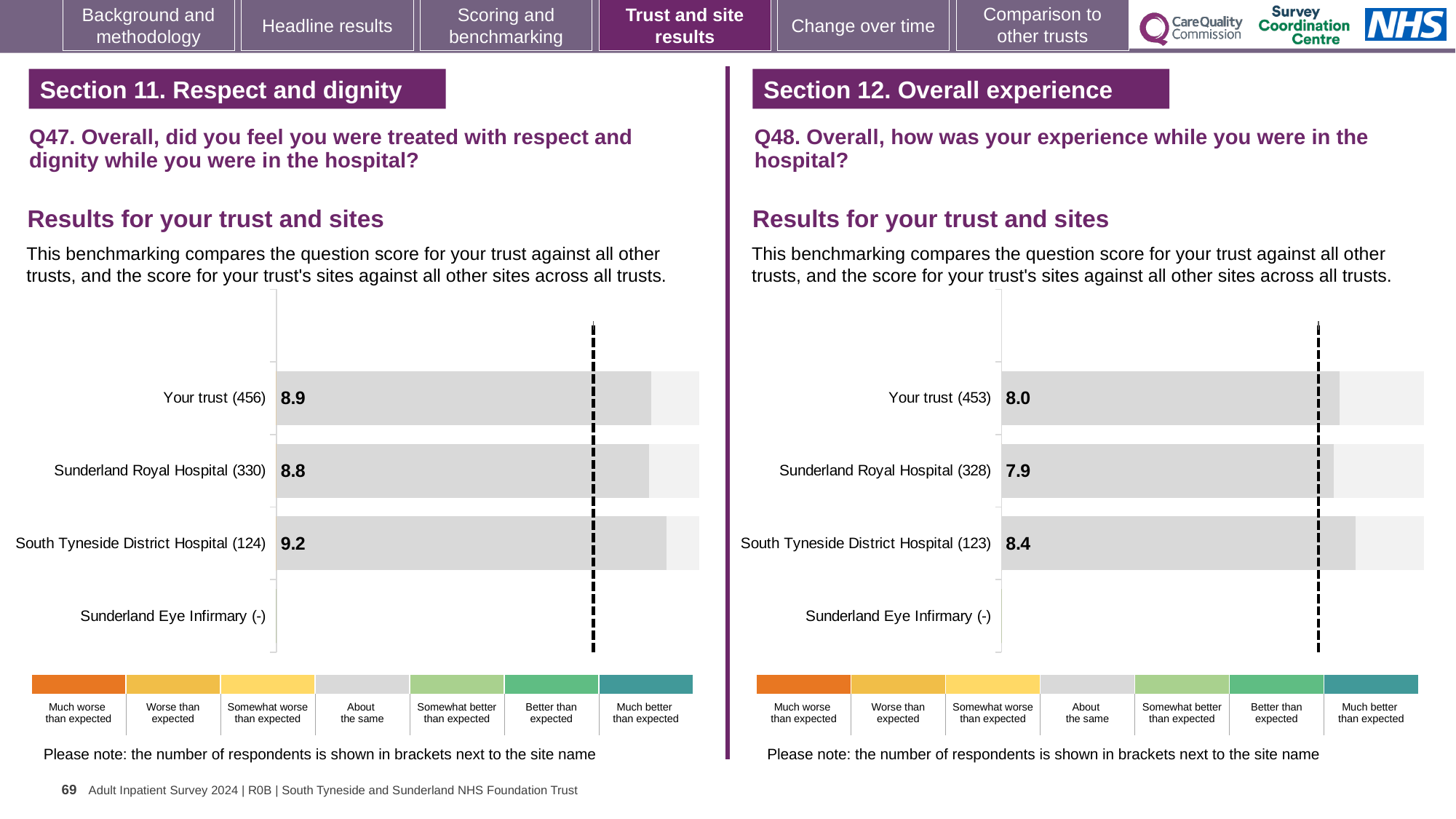
How many rows (trust and sites) are listed on the Q47 chart (Section 11. Respect and dignity)? 4 On the Q47 chart (Section 11. Respect and dignity), how many respondents are shown in brackets for Sunderland Royal Hospital? 330 On the Q47 chart (Section 11. Respect and dignity), what is the score for Your trust? 8.9 On the Q47 chart (Section 11. Respect and dignity), what is the difference between the scores for South Tyneside District Hospital and Sunderland Royal Hospital? 0.4 On the Q48 chart (Section 12. Overall experience), which has the higher score: Your trust or South Tyneside District Hospital? South Tyneside District Hospital What kind of chart is used on the Q48 chart (Section 12. Overall experience)? Bar chart On the Q47 chart (Section 11. Respect and dignity), what is the score for South Tyneside District Hospital? 9.2 On the Q48 chart (Section 12. Overall experience), what is the difference between the scores for South Tyneside District Hospital and Your trust? 0.4 On the Q48 chart (Section 12. Overall experience), what is the score for Your trust? 8.0 On the Q47 chart (Section 11. Respect and dignity), which site has the highest score? South Tyneside District Hospital On the Q48 chart (Section 12. Overall experience), which site has the lowest score among those with a score shown? Sunderland Royal Hospital On the Q48 chart (Section 12. Overall experience), what is the score for Sunderland Royal Hospital? 7.9